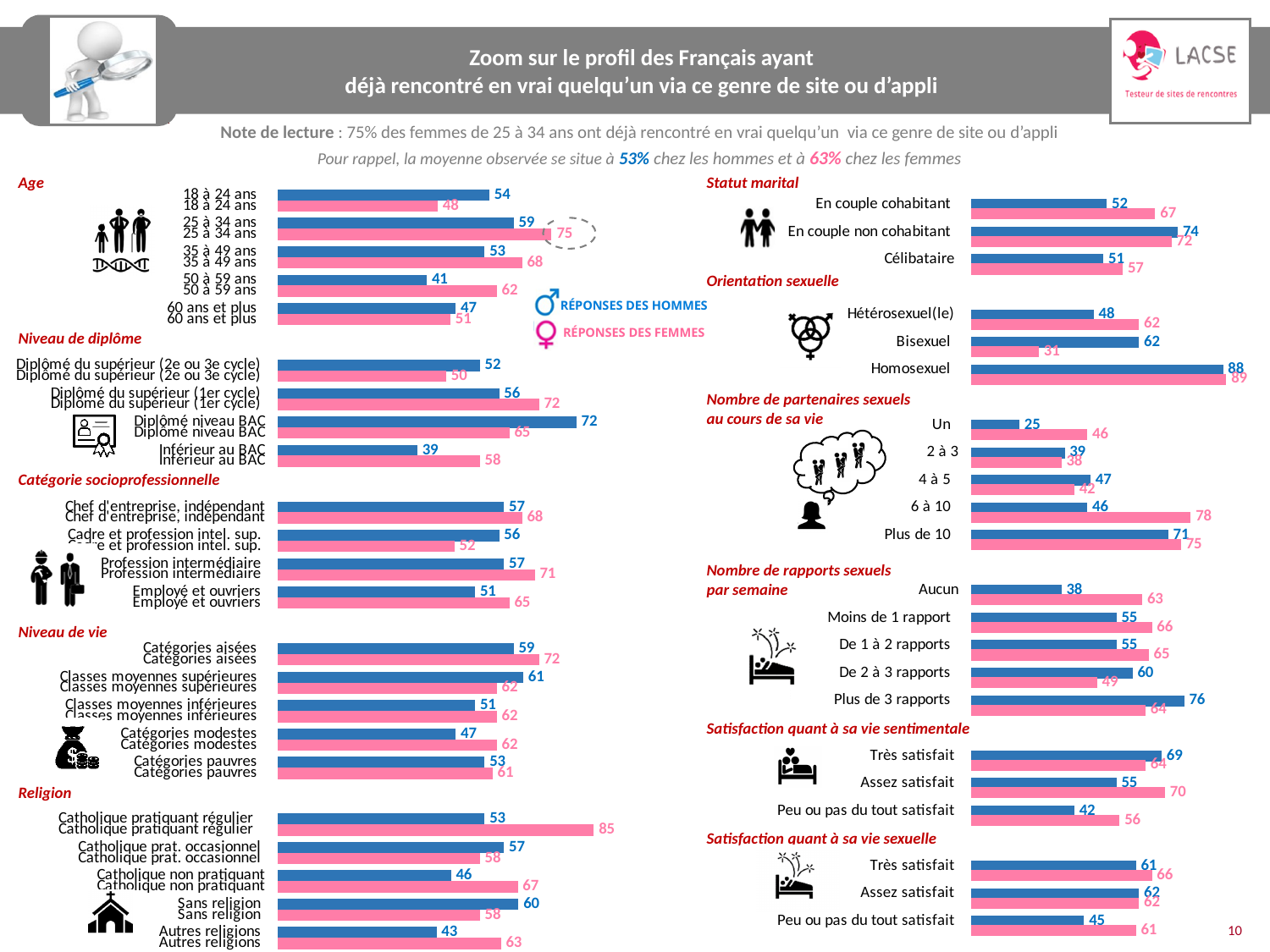
In the Religion chart, what is the value for women for Catholique pratiquant régulier? 85 What kind of chart is used in the Age section? bar chart In the Catégorie socioprofessionnelle chart, what is the difference between the women's and men's values for Profession intermédiaire? 14 Which colour represents the women's responses (réponses des femmes) in the charts? pink How many series does the legend list (réponses des hommes / réponses des femmes)? 2 In the Nombre de rapports sexuels par semaine chart, which is larger for De 2 à 3 rapports: the men's value or the women's value? the men's value In the Satisfaction quant à sa vie sentimentale chart, what is the men's value for Peu ou pas du tout satisfait? 42 In the Niveau de diplôme chart, which category has the lowest value for men? Inférieur au BAC In the Age chart, what is the value for women (réponses des femmes) aged 25 à 34 ans? 75 In the Nombre de partenaires sexuels au cours de sa vie chart, what is the difference between the women's and men's values for 6 à 10? 32 How many categories are shown in the Statut marital chart? 3 In the Orientation sexuelle chart, which category has the highest value for men (réponses des hommes)? Homosexuel